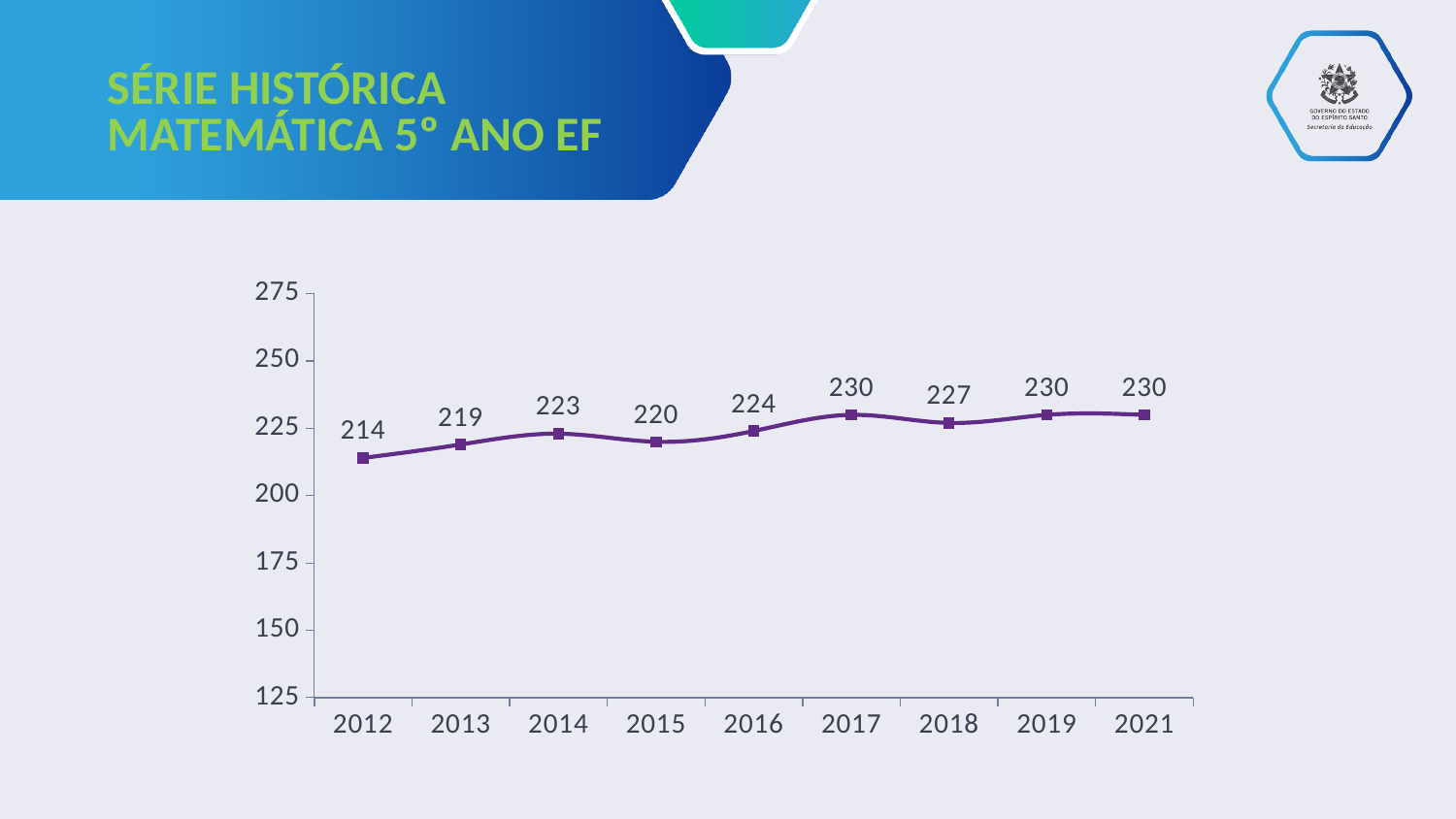
Do the values generally rise or fall from 2012 to 2021? rise What is the value for 2015? 220 Is the value for 2019 greater or less than 225? greater What is the difference between the values for 2021 and 2012? 16 What is the difference between the values for 2017 and 2018? 3 What kind of chart is shown? line chart Is the value for 2013 greater or less than 225? less Which is larger, the value for 2014 or the value for 2015? 2014 What is the value for 2012? 214 How many years are plotted on the chart? 9 Which year has the lowest value? 2012 What is the value for 2018? 227